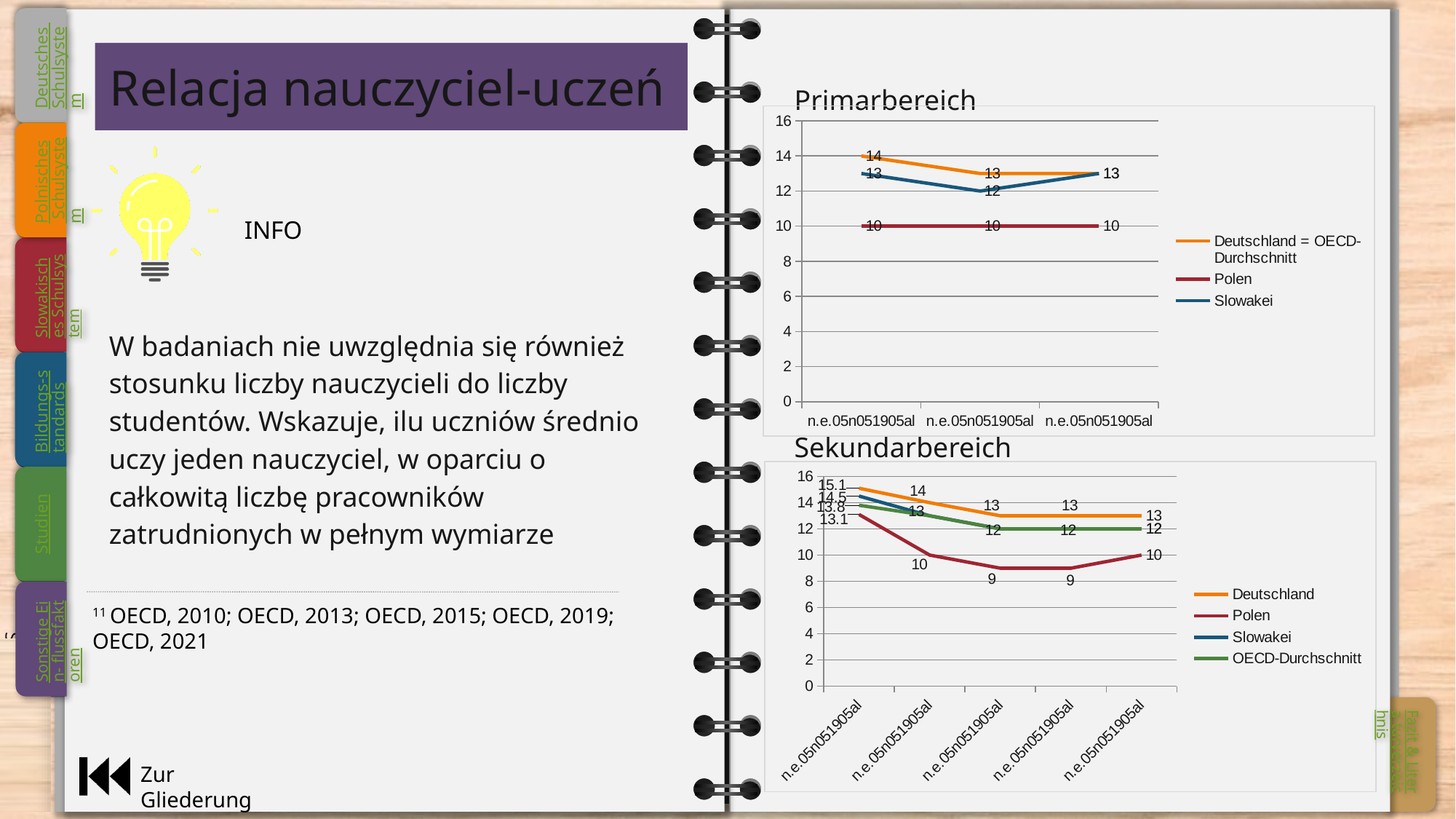
How many series does the legend of the Sekundarbereich chart list? 4 In the Primarbereich chart, which series has the lowest values across all points? Polen In the Primarbereich chart, what is the value for Slowakei at the second point? 12 In the Sekundarbereich chart, how many points are plotted along the x axis? 5 In the Primarbereich chart, what is the difference between Deutschland = OECD-Durchschnitt and Polen at the first point? 4 How many series does the legend of the Primarbereich chart list? 3 In the Primarbereich chart, what is the value for Deutschland = OECD-Durchschnitt at the first point? 14 In the Primarbereich chart, what is the value for Polen at the first point? 10 In the Sekundarbereich chart, what is the value for Deutschland at the first point? 15.1 In the Sekundarbereich chart, does the Polen series rise or fall from the first point to the third point? fall What type of chart is the Primarbereich chart? line chart In the Sekundarbereich chart, what is the value for Polen at the third point? 9